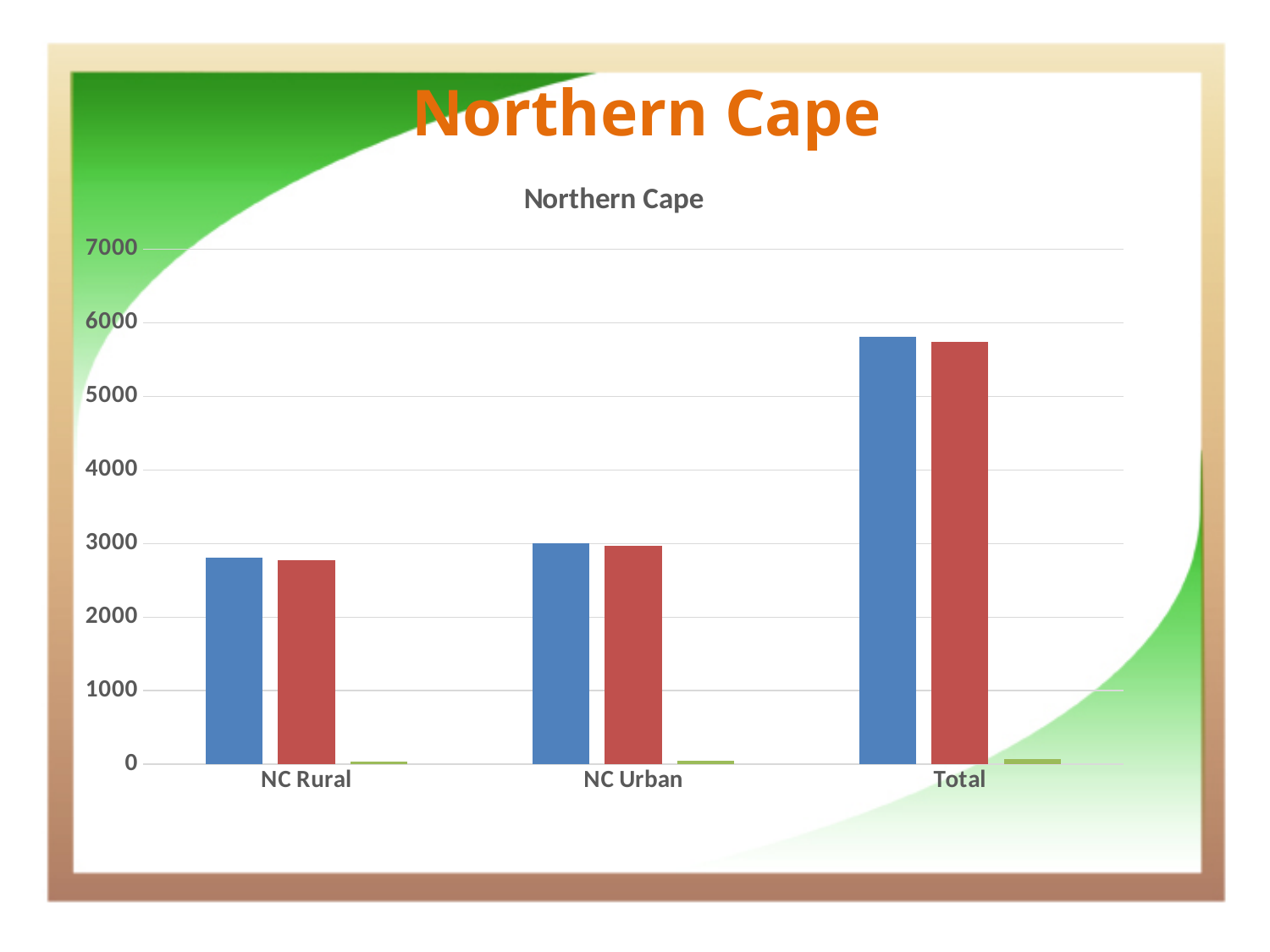
Is the red bar for Total greater or less than 6000? less How many categories are shown on the x axis? 3 Which category has the tallest blue bar? Total Which category has the shortest red bar? NC Rural Which is larger for Total, the blue bar or the green bar? the blue bar What is the title of the chart? Northern Cape What kind of chart is shown on the slide? bar chart Is the blue bar for NC Rural greater or less than 2000? greater Which is larger, the blue bar for NC Urban or the blue bar for NC Rural? NC Urban Is the blue bar for Total greater or less than 5000? greater How many bars are plotted for each category? 3